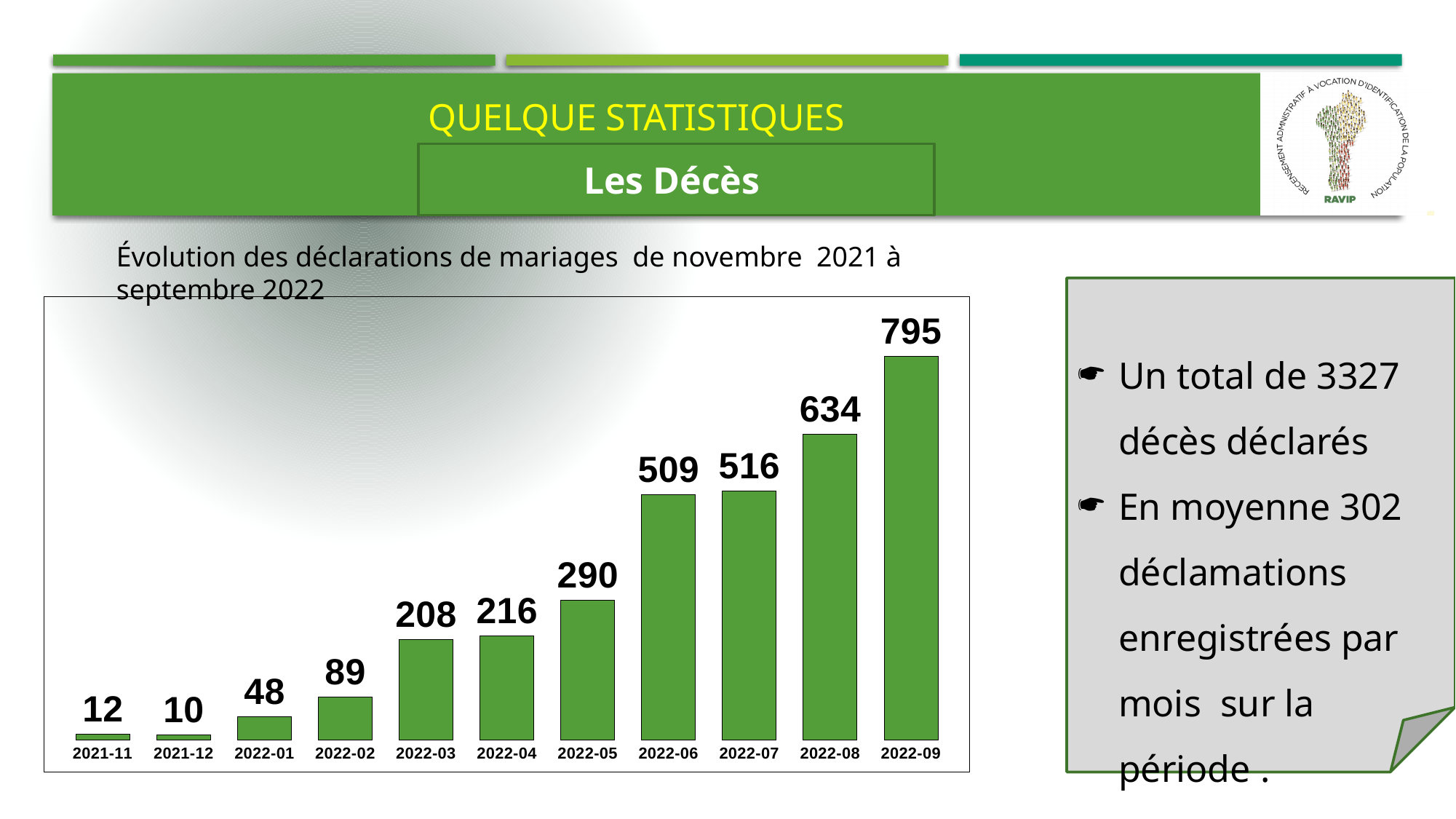
What is the value for 2022-09? 795 Which is larger, the value for 2022-06 or the value for 2022-07? 2022-07 Do the values generally rise or fall from 2021-11 to 2022-09? rise What is the difference between the values for 2022-05 and 2022-04? 74 What is the difference between the values for 2022-09 and 2022-08? 161 What colour are the bars in the chart? green What is the value for 2022-03? 208 Which month has the lowest value? 2021-12 What is the value for 2021-11? 12 What kind of chart is shown on the slide? bar chart How many months are shown on the x axis? 11 Which month has the highest value? 2022-09